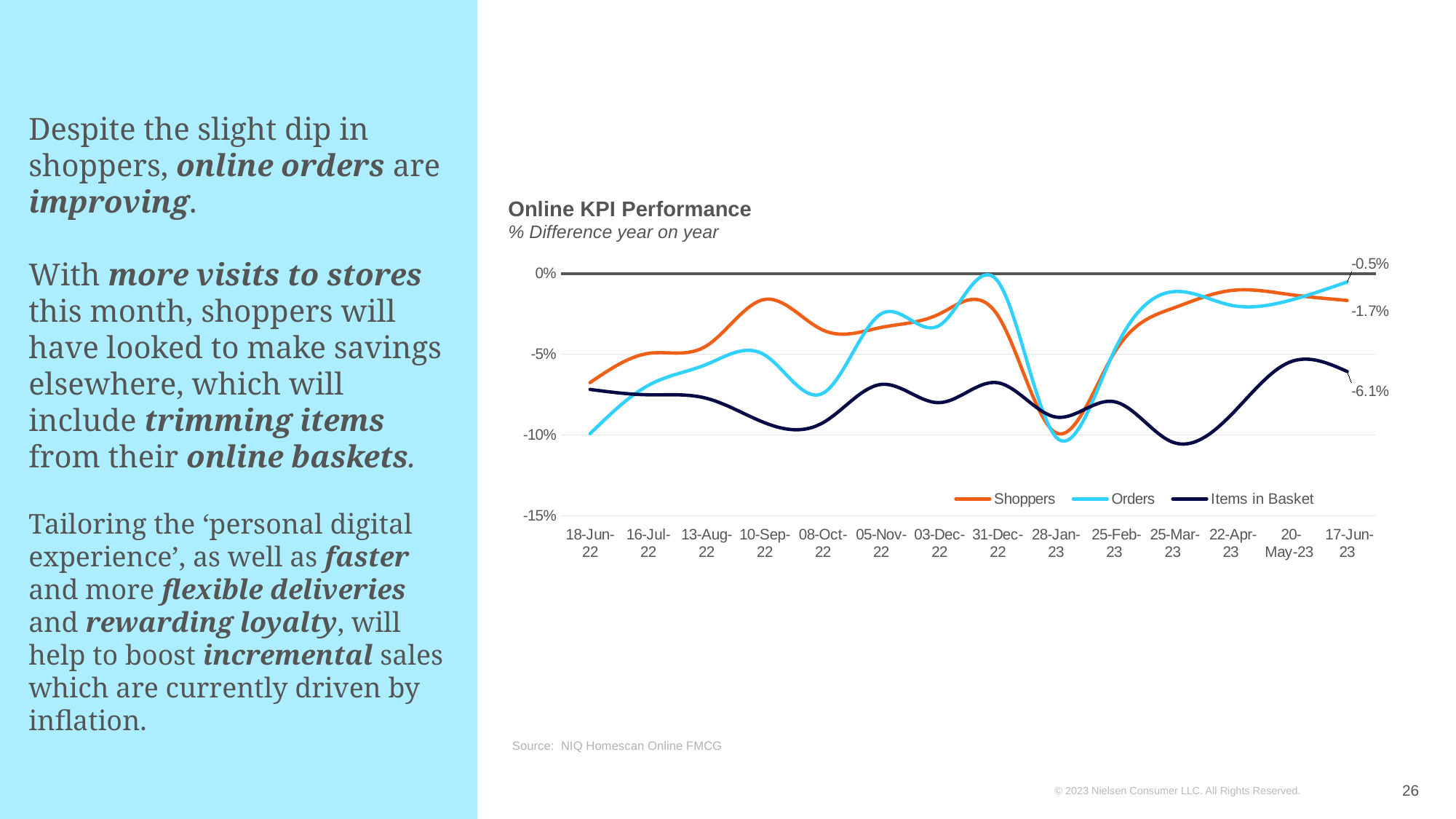
Which series has the lowest value at 17-Jun-23? Items in Basket What is the value for Orders at 17-Jun-23? -0.5% At 17-Jun-23, what is the difference between the Orders value and the Items in Basket value? 5.6 percentage points What kind of chart is shown on the slide? Line chart How many series does the legend of the Online KPI Performance chart list? 3 At 17-Jun-23, which is higher: Orders or Shoppers? Orders What is the value for Items in Basket at 17-Jun-23? -6.1% Is the value for Orders at 18-Jun-22 greater or less than -5%? less What is the subtitle of the Online KPI Performance chart? % Difference year on year Does the Items in Basket line rise or fall between 25-Mar-23 and 20-May-23? Rise What is the value for Shoppers at 17-Jun-23? -1.7% How many dates are shown along the x axis of the Online KPI Performance chart? 14